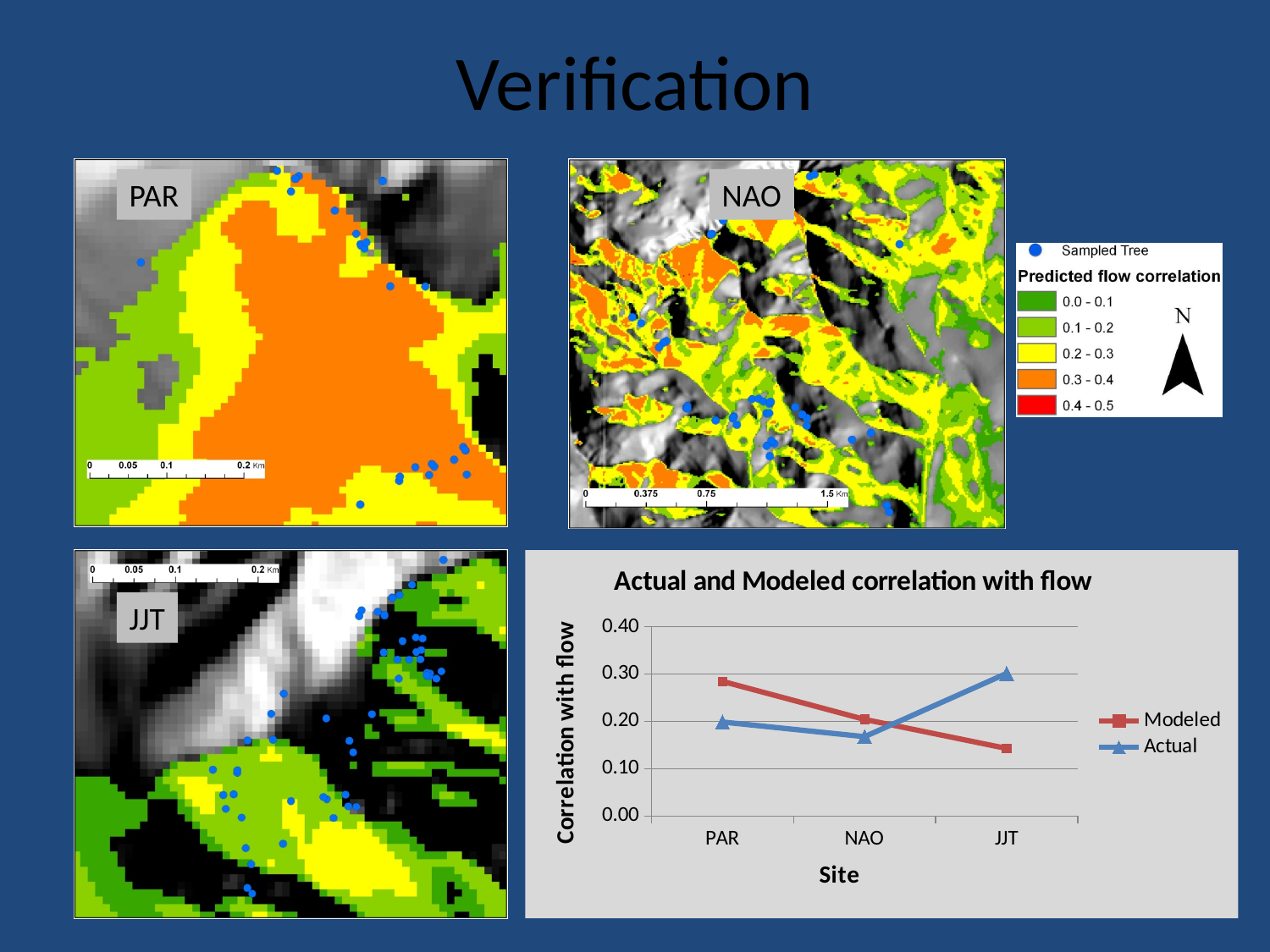
What is the x-axis title of the "Actual and Modeled correlation with flow" chart? Site In the "Actual and Modeled correlation with flow" chart, at which site is the Modeled series highest? PAR In the "Actual and Modeled correlation with flow" chart, at which site is the Actual series highest? JJT In the "Actual and Modeled correlation with flow" chart, does the Modeled series rise or fall from PAR to JJT? fall How many series does the legend of the "Actual and Modeled correlation with flow" chart list? 2 How many sites are shown on the x axis of the "Actual and Modeled correlation with flow" chart? 3 What type of chart is "Actual and Modeled correlation with flow"? line chart In the "Actual and Modeled correlation with flow" chart, which series has the larger value at PAR, Modeled or Actual? Modeled In the "Actual and Modeled correlation with flow" chart, is the Modeled value for PAR greater or less than 0.20? greater In the "Actual and Modeled correlation with flow" chart, is the Modeled value for JJT greater or less than 0.20? less In the "Actual and Modeled correlation with flow" chart, is the Actual value for JJT greater or less than 0.20? greater In the "Actual and Modeled correlation with flow" chart, at which site is the Modeled series lowest? JJT